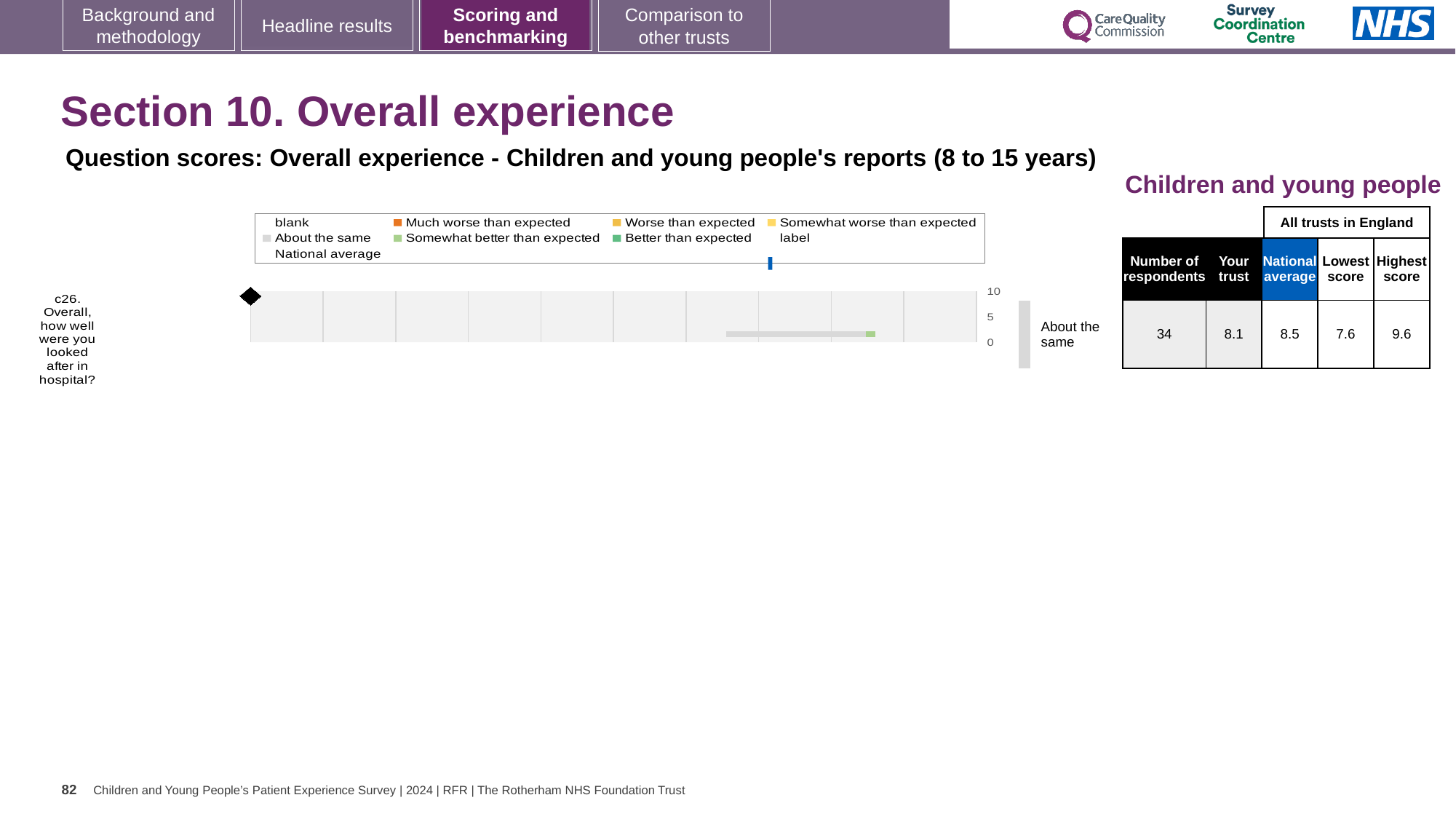
What is the difference between the highest score and the lowest score for question c26? 2.0 By how much does the national average exceed the 'Your trust' score for question c26? 0.4 What is the lowest score among all trusts in England for question c26? 7.6 How many survey questions are plotted on the chart? 1 For question c26, which is larger: the 'Your trust' score or the national average? National average How many respondents answered question c26? 34 What kind of chart is used to show the c26 question score? bar chart Which benchmark category is question c26 (Overall, how well were you looked after in hospital?) placed in? About the same What is the national average score for question c26? 8.5 What is the highest score among all trusts in England for question c26? 9.6 What is the 'Your trust' score for question c26? 8.1 What is the maximum value shown on the chart's score axis? 10